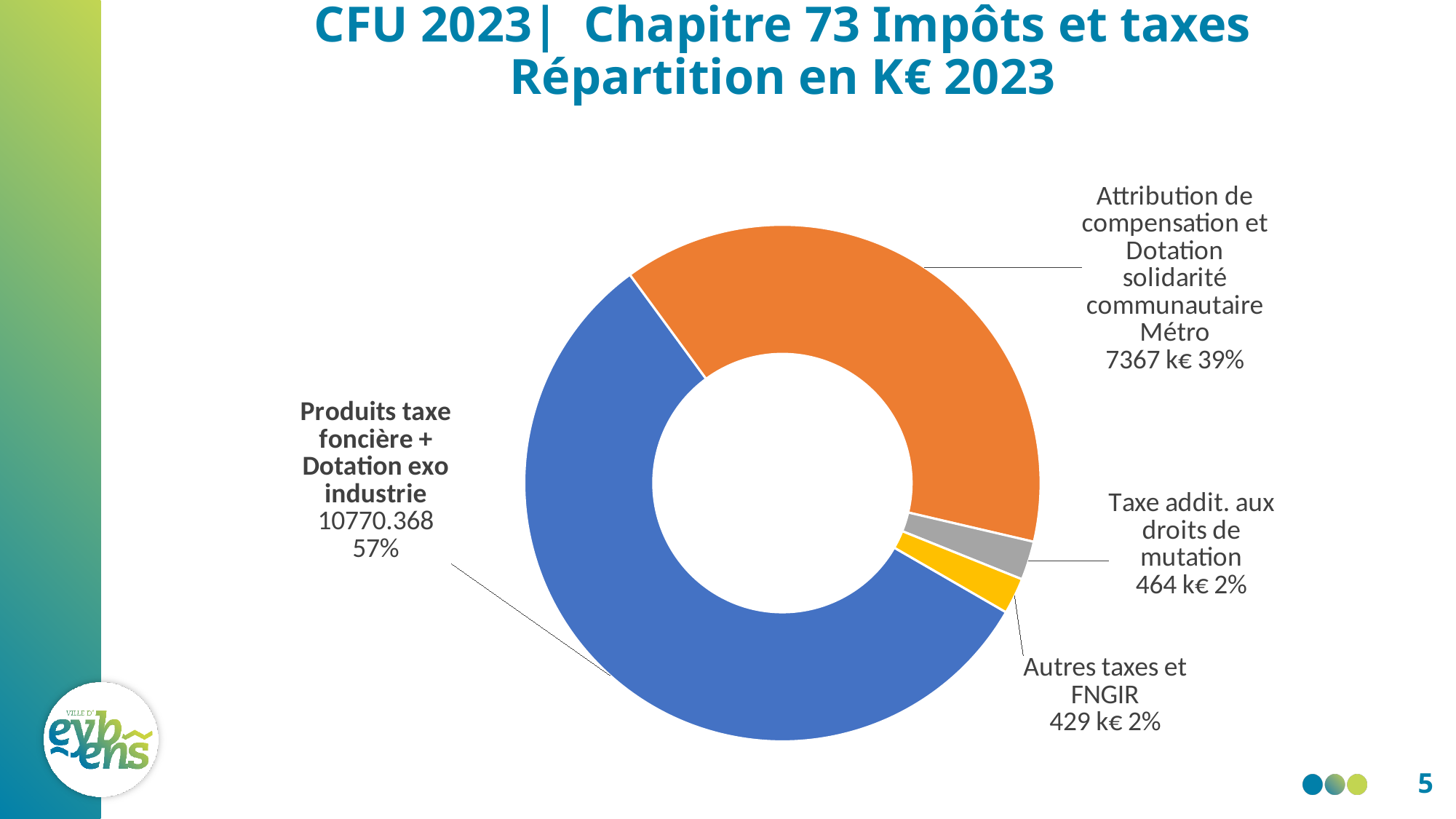
What is the difference between the values for "Taxe addit. aux droits de mutation" and "Autres taxes et FNGIR"? 35 k€ Which category has the largest share of the chart? Produits taxe foncière + Dotation exo industrie What share of the chart does "Attribution de compensation et Dotation solidarité communautaire Métro" represent? 39% What value is shown for "Taxe addit. aux droits de mutation"? 464 k€ What share of the chart does "Produits taxe foncière + Dotation exo industrie" represent? 57% Which category has the smallest value in the chart? Autres taxes et FNGIR Which colour is used for the "Attribution de compensation et Dotation solidarité communautaire Métro" slice? orange What value is shown for "Attribution de compensation et Dotation solidarité communautaire Métro"? 7367 k€ What value is shown for "Produits taxe foncière + Dotation exo industrie"? 10770.368 What value is shown for "Autres taxes et FNGIR"? 429 k€ What kind of chart is shown on the slide? doughnut chart How many slices does the chart have? 4